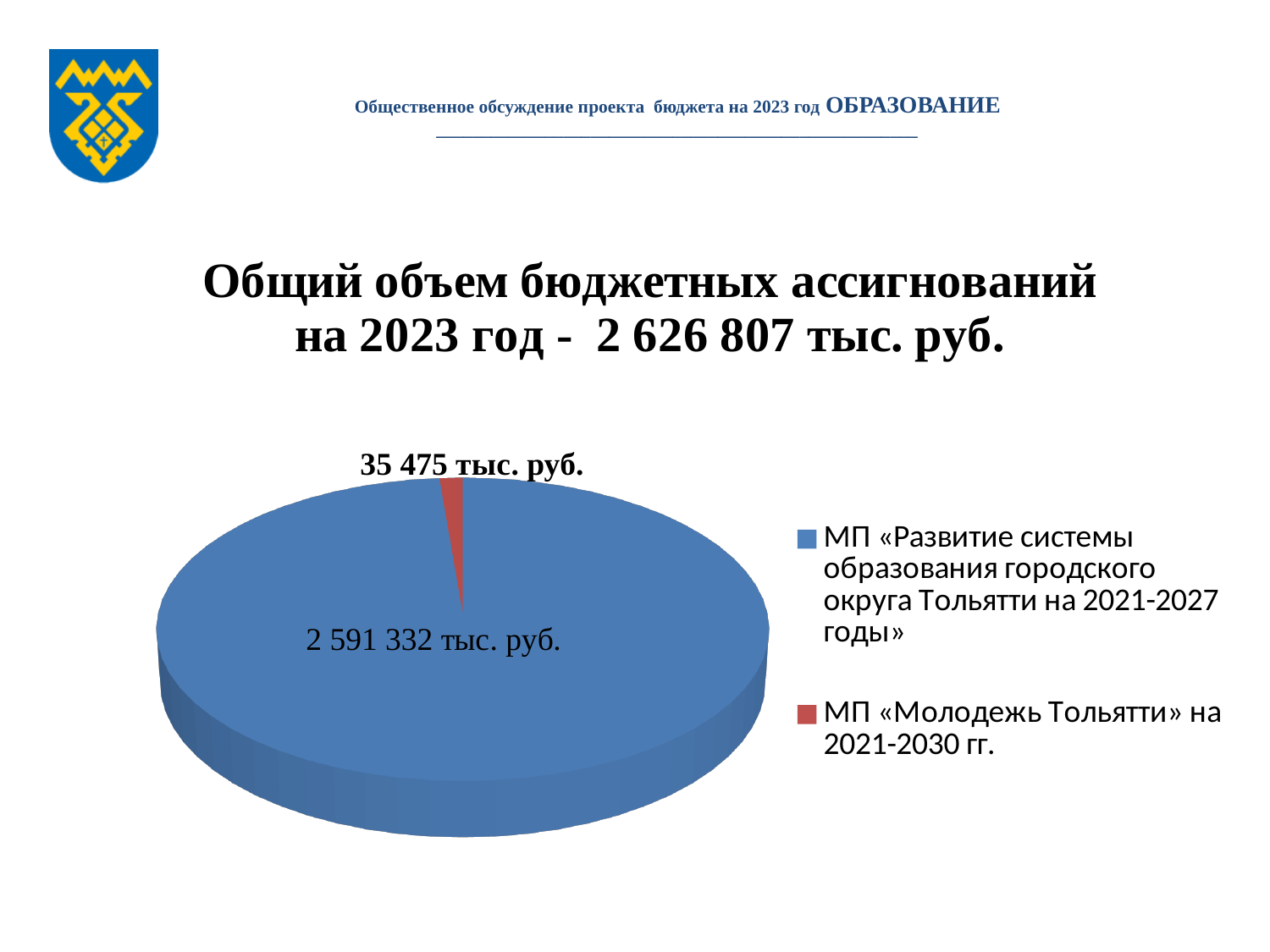
What share of the total does МП «Молодежь Тольятти» на 2021-2030 гг. represent? 1.35% What is the value for МП «Молодежь Тольятти» на 2021-2030 гг.? 35 475 тыс. руб. What is the total of the two slices in the pie chart? 2 626 807 тыс. руб. What colour is the slice for МП «Молодежь Тольятти» на 2021-2030 гг.? Red Which is larger: the value for МП «Молодежь Тольятти» or the value for МП «Развитие системы образования»? МП «Развитие системы образования» What kind of chart is shown on the slide? Pie chart How many entries does the legend list? 2 What is the difference between the value for МП «Развитие системы образования» and the value for МП «Молодежь Тольятти»? 2 555 857 тыс. руб. Which programme has the smallest slice of the pie? МП «Молодежь Тольятти» на 2021-2030 гг. How many slices does the pie chart have? 2 Which programme has the largest slice of the pie? МП «Развитие системы образования городского округа Тольятти на 2021-2027 годы» What is the value for МП «Развитие системы образования городского округа Тольятти на 2021-2027 годы»? 2 591 332 тыс. руб.